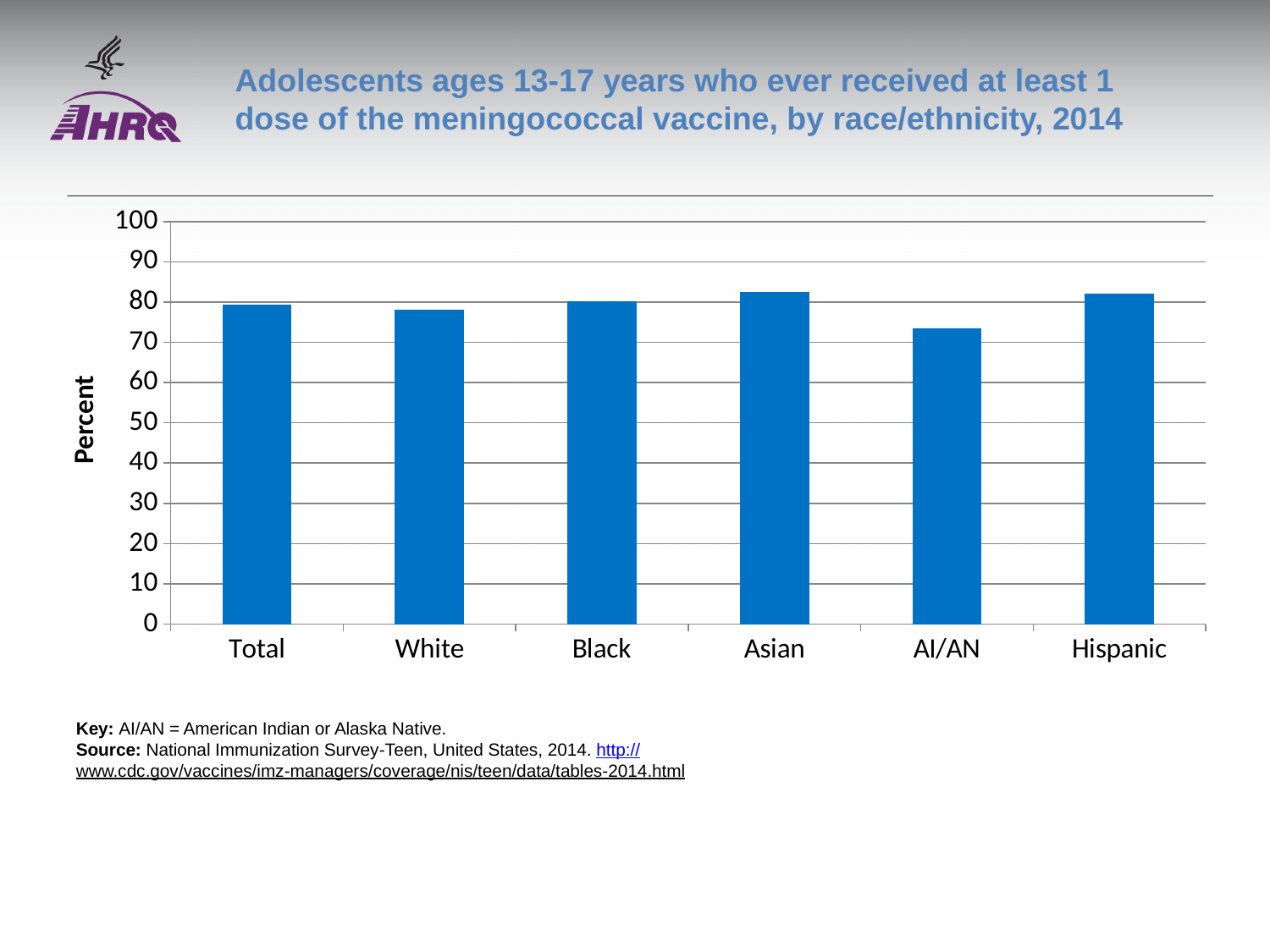
Is the value for Hispanic greater or less than 80? greater What is the label on the vertical axis of the chart? Percent What is the highest value shown on the vertical axis of the chart? 100 Which category has the lowest percentage in the chart? AI/AN Which is larger, the value for White or the value for AI/AN? White How many race/ethnicity categories are shown on the x axis of the chart? 6 Is the value for White greater or less than 80? less Is the value for Asian greater or less than 80? greater Which is larger, the value for Asian or the value for AI/AN? Asian What kind of chart is shown on the slide? bar chart